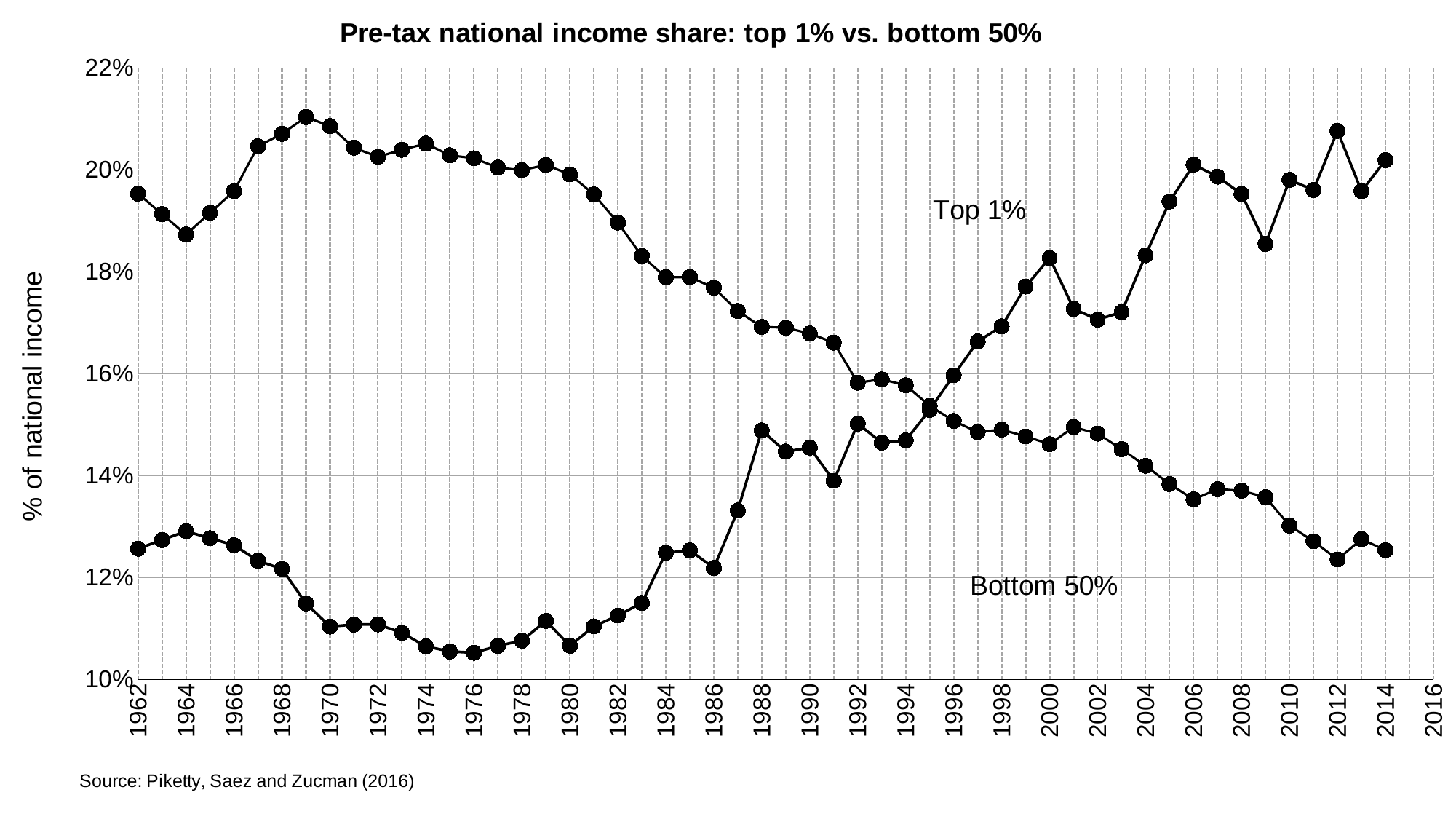
Is the Top 1% value in 2012 greater or less than 20%? greater Which is larger for the Top 1% series: the value in 1969 or the value in 1995? 1995 Is the Bottom 50% value in 1976 greater or less than 12%? greater Does the Bottom 50% series rise or fall between 2001 and 2012? fall What is the label on the y axis of the chart? % of national income Is the Bottom 50% value in 1988 greater or less than 14%? greater Does the Top 1% series rise or fall between 1969 and 1995? rise What kind of chart is shown on the slide? line chart What is the title of the chart? Pre-tax national income share: top 1% vs. bottom 50% How many series are plotted on the chart? 2